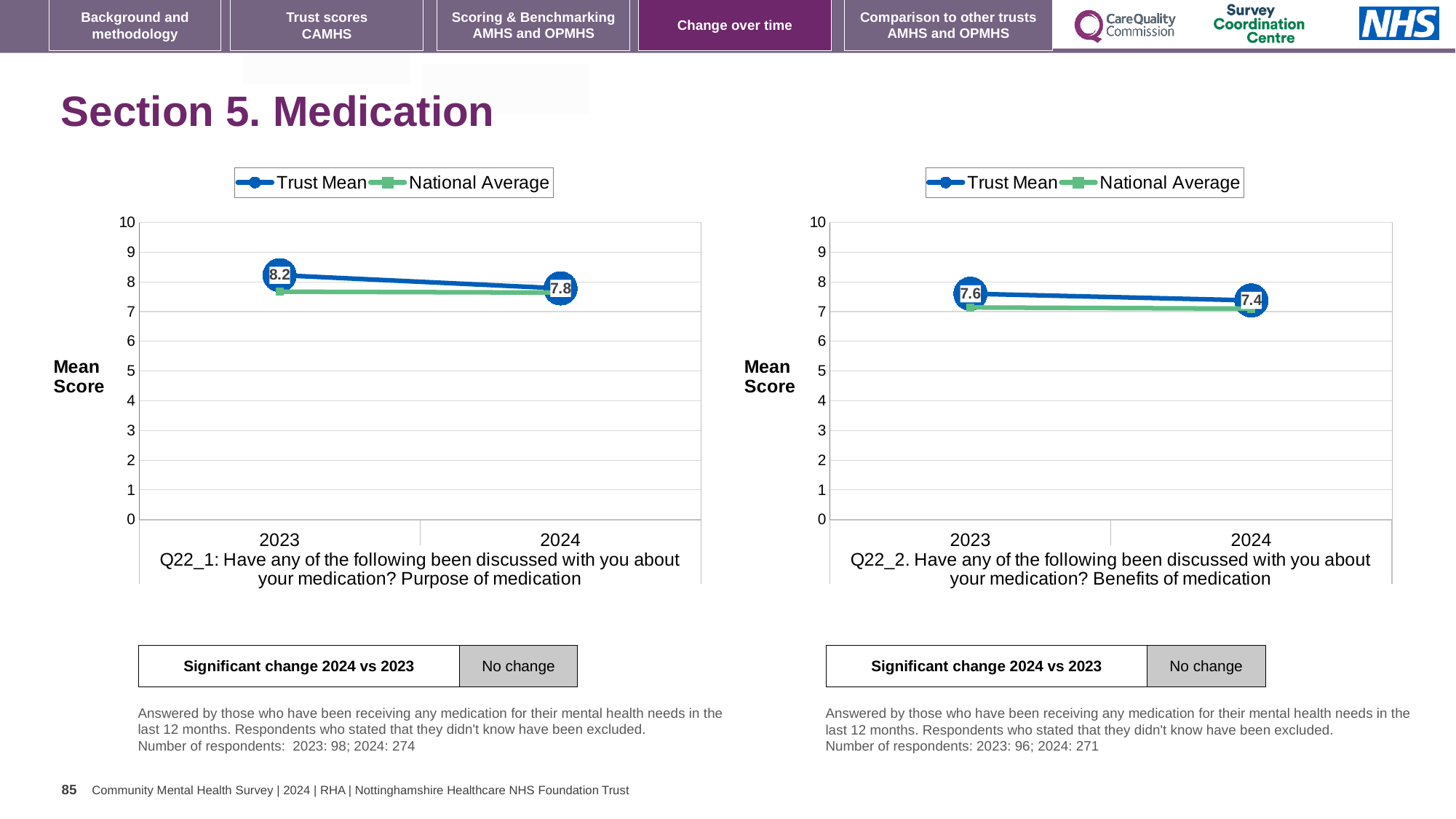
In the left chart (Q22_1: Purpose of medication), by how much did the Trust Mean change from 2023 to 2024? 0.4 How many series does the legend of the right chart (Q22_2: Benefits of medication) list? 2 In the right chart (Q22_2: Benefits of medication), which is larger in 2023, the Trust Mean or the National Average? Trust Mean What kind of chart is used on this slide? line chart In the right chart (Q22_2: Benefits of medication), what is the Trust Mean for 2024? 7.4 In the left chart (Q22_1: Purpose of medication), does the Trust Mean rise or fall from 2023 to 2024? fall How many years are shown on the x axis of the left chart (Q22_1: Purpose of medication)? 2 In the right chart (Q22_2: Benefits of medication), what is the difference between the Trust Mean in 2023 and 2024? 0.2 In the right chart (Q22_2: Benefits of medication), what is the Trust Mean for 2023? 7.6 In the left chart (Q22_1: Purpose of medication), is the National Average for 2023 greater or less than 7? greater In the left chart (Q22_1: Purpose of medication), what is the Trust Mean for 2024? 7.8 In the left chart (Q22_1: Purpose of medication), what is the Trust Mean for 2023? 8.2